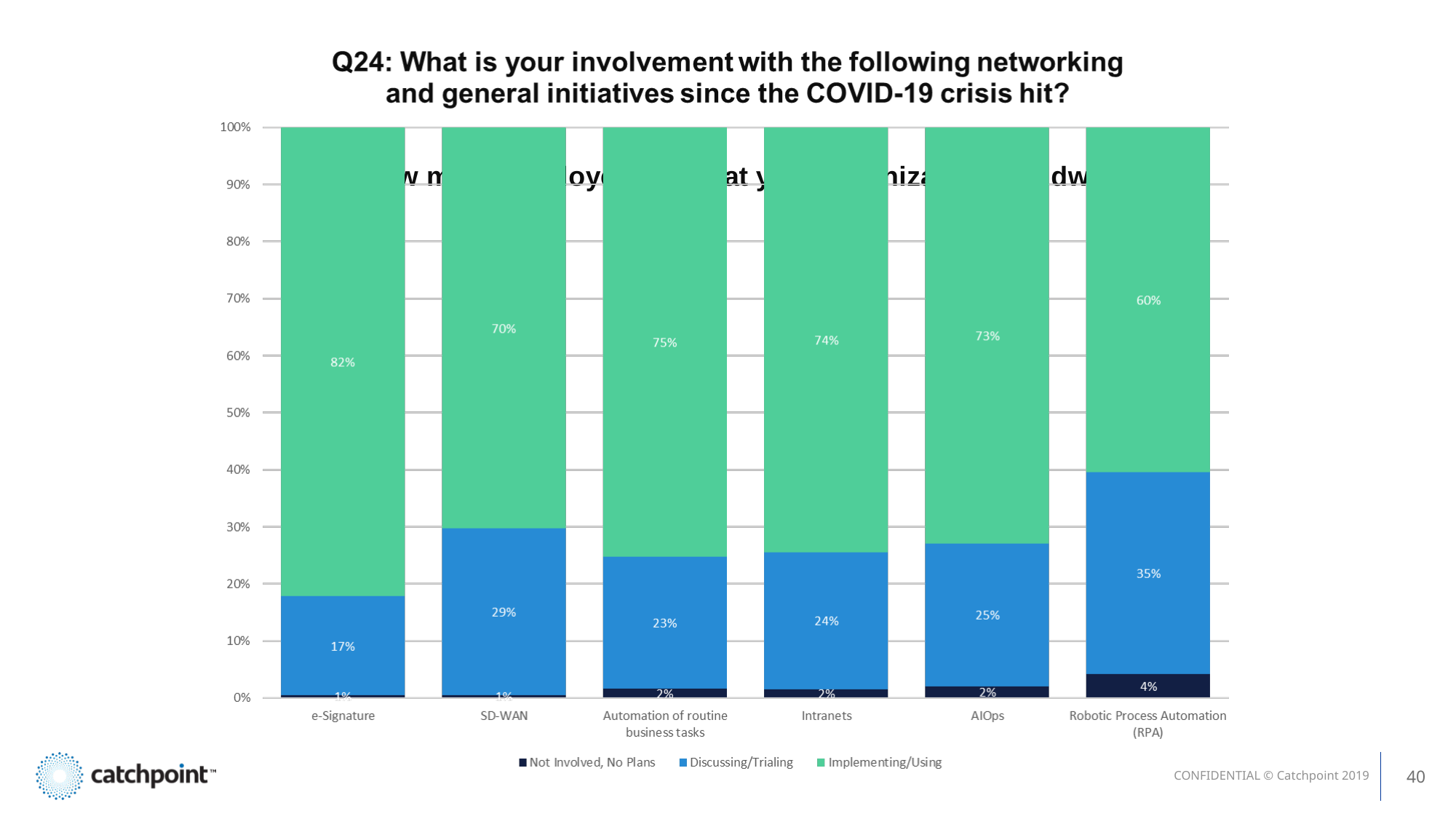
Which series is shown in green in the legend? Implementing/Using What percentage of respondents are Implementing/Using e-Signature? 82% What is the Discussing/Trialing value for Robotic Process Automation (RPA)? 35% Which has a larger Discussing/Trialing value, SD-WAN or Intranets? SD-WAN Which initiative has the lowest Implementing/Using percentage? Robotic Process Automation (RPA) Which initiative has the highest Not Involved, No Plans percentage? Robotic Process Automation (RPA) How many initiatives are shown on the x axis? 6 What is the Not Involved, No Plans value for AIOps? 2% What is the difference between the Implementing/Using values for SD-WAN and Robotic Process Automation (RPA)? 10% What kind of chart is shown on the slide? Stacked bar chart How many series does the legend list? 3 Which initiative has the highest Implementing/Using percentage? e-Signature